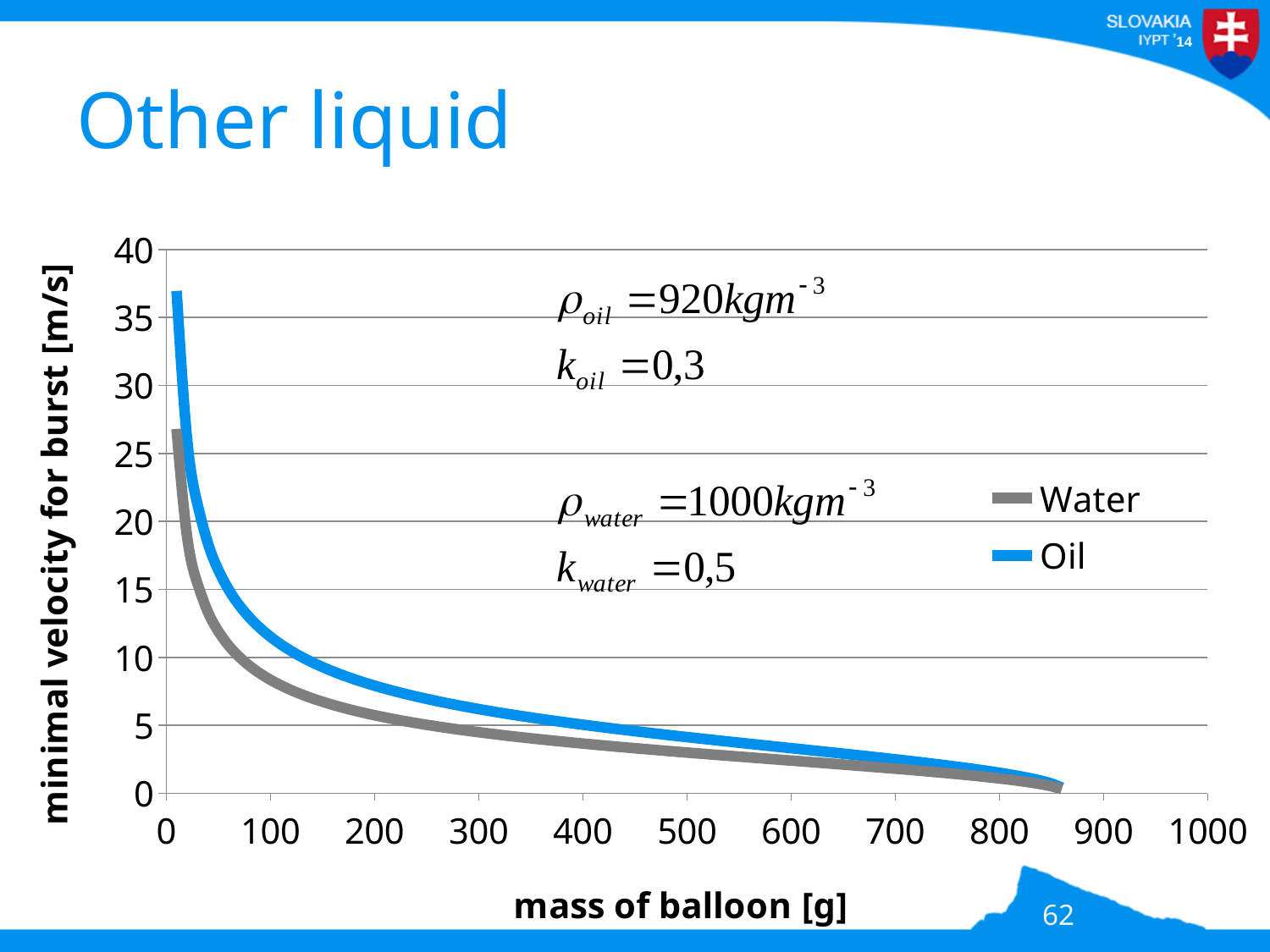
At a mass of 100 g, which series has the larger value, Water or Oil? Oil At a mass of 100 g, is the value for Oil greater or less than 10? greater Do the values for Oil rise or fall as the mass of balloon increases? fall Which series are listed in the legend? Water and Oil How many series does the legend list? 2 At a mass of 300 g, which series has the larger value, Water or Oil? Oil What kind of chart is shown on the slide? line chart At a mass of 100 g, is the value for Water greater or less than 10? less Do the values for Water rise or fall as the mass of balloon increases? fall At a mass of 600 g, is the value for Water greater or less than 5? less What is the title of the x axis? mass of balloon [g]